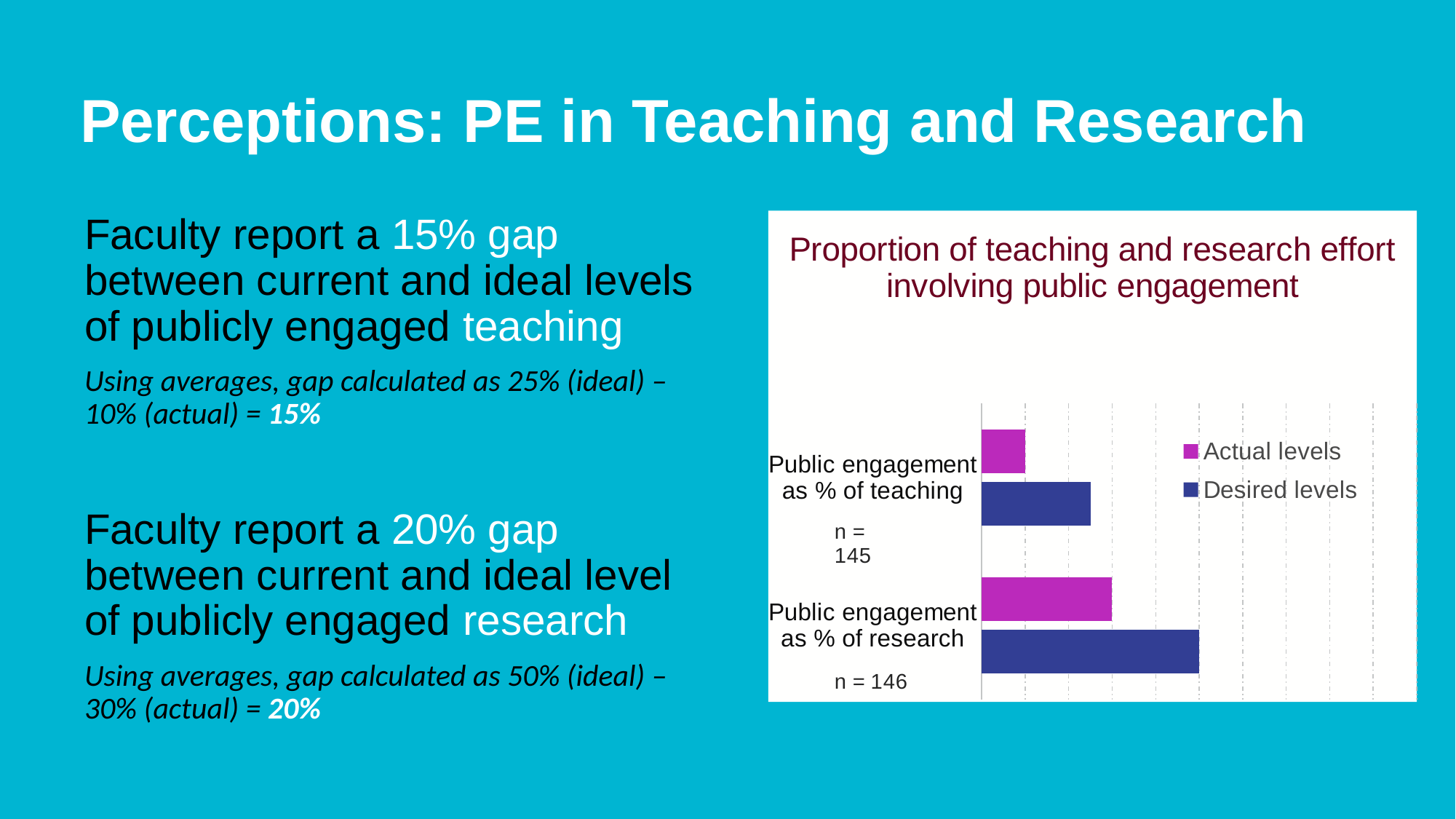
For public engagement as % of research, which is larger: actual levels or desired levels? Desired levels Which bar on the chart is the longest? Desired levels for public engagement as % of research How many series does the chart legend list? 2 What kind of chart is shown on the slide? bar chart Which category has the higher desired level: teaching or research? Public engagement as % of research Which colour represents Actual levels in the chart legend? Magenta (purple-pink) Which category has the higher actual level: teaching or research? Public engagement as % of research How many categories are plotted on the chart? 2 Which bar on the chart is the shortest? Actual levels for public engagement as % of teaching What is the title of the chart? Proportion of teaching and research effort involving public engagement